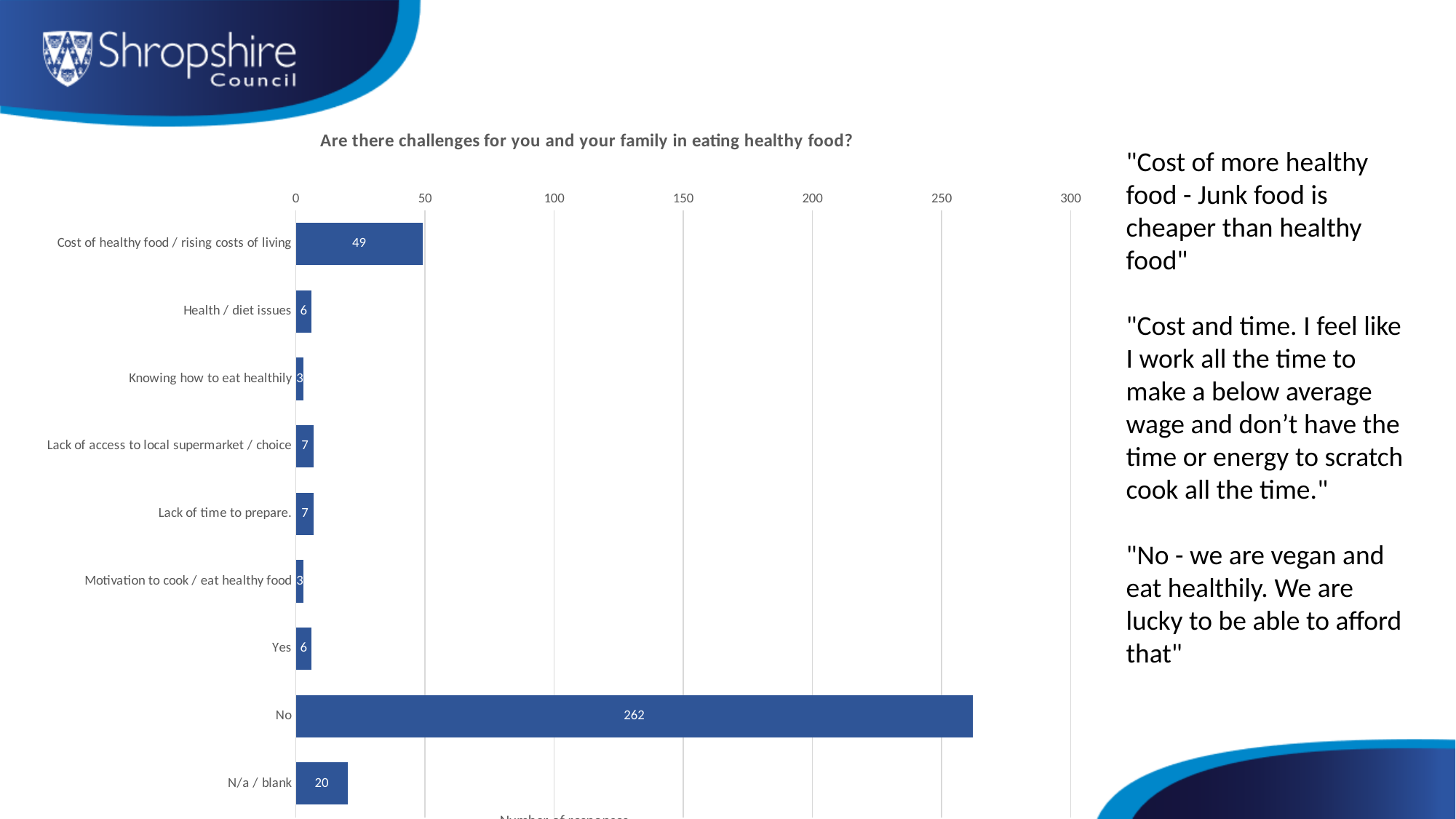
How many categories are shown in the chart? 9 What is the value for "No"? 262 Which is larger, the value for "Yes" or the value for "N/a / blank"? N/a / blank Is the value for "No" greater or less than 250? greater What is the value for "Cost of healthy food / rising costs of living"? 49 What is the value for "N/a / blank"? 20 What kind of chart is shown on the slide? Bar chart What is the title of the chart? Are there challenges for you and your family in eating healthy food? What is the value for "Lack of time to prepare."? 7 Which category has the highest value? No What is the difference between the values for "Cost of healthy food / rising costs of living" and "N/a / blank"? 29 What is the difference between the values for "No" and "Cost of healthy food / rising costs of living"? 213